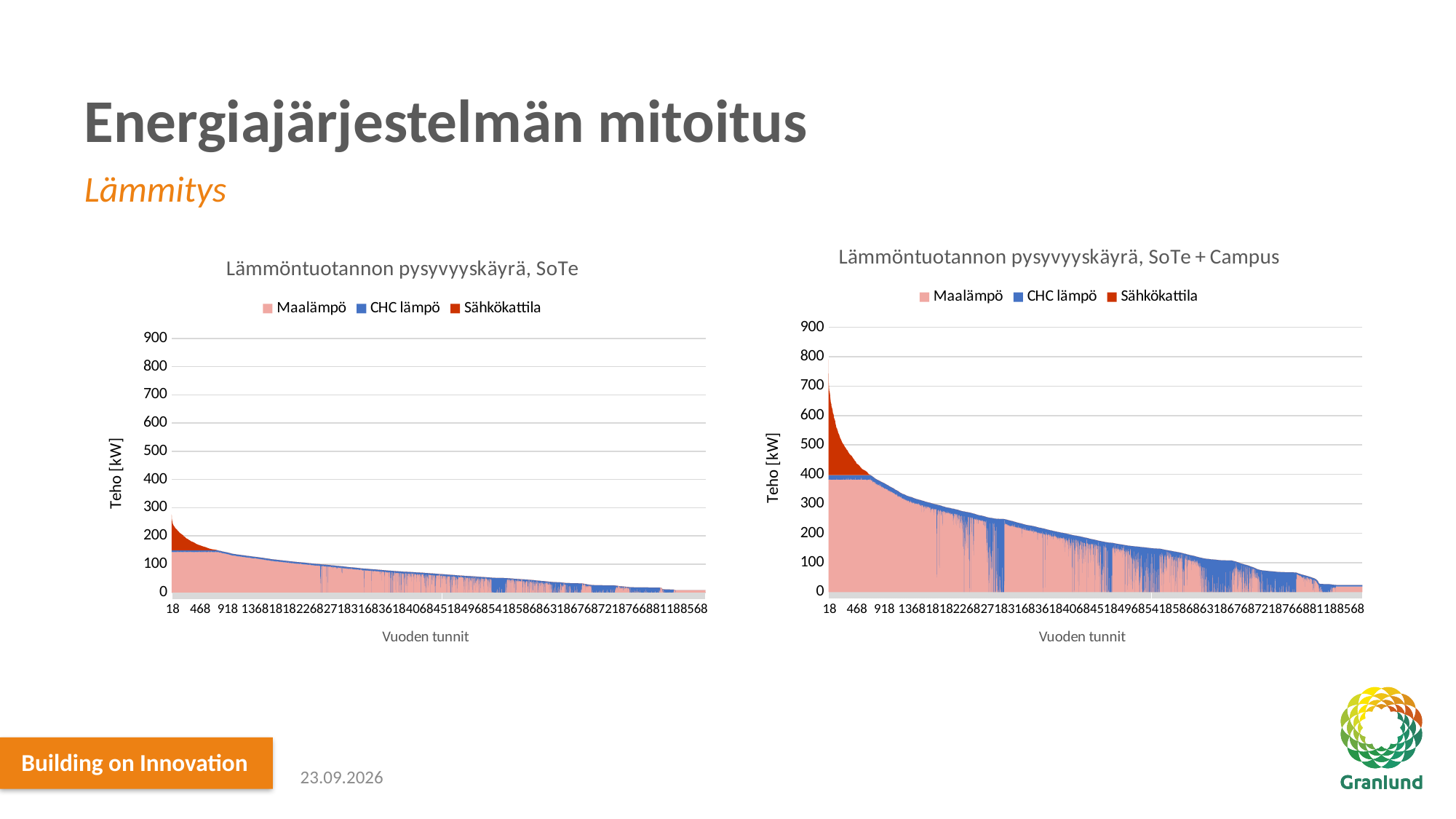
What is the y-axis label of the right chart, 'Lämmöntuotannon pysyvyyskäyrä, SoTe + Campus'? Teho [kW] In the left chart, 'Lämmöntuotannon pysyvyyskäyrä, SoTe', do the values rise or fall along the x axis? Fall In the right chart, 'Lämmöntuotannon pysyvyyskäyrä, SoTe + Campus', is the highest total value (at the left edge) greater or less than 700? greater Which chart reaches a higher peak total value: 'Lämmöntuotannon pysyvyyskäyrä, SoTe' or 'Lämmöntuotannon pysyvyyskäyrä, SoTe + Campus'? Lämmöntuotannon pysyvyyskäyrä, SoTe + Campus In the left chart, 'Lämmöntuotannon pysyvyyskäyrä, SoTe', is the flat top of the Maalämpö area at the left greater or less than 100? greater In the left chart, 'Lämmöntuotannon pysyvyyskäyrä, SoTe', which series are listed in the legend? Maalämpö, CHC lämpö, Sähkökattila In the right chart, 'Lämmöntuotannon pysyvyyskäyrä, SoTe + Campus', do the values rise or fall along the x axis? Fall How many series does the legend of the right chart, 'Lämmöntuotannon pysyvyyskäyrä, SoTe + Campus', list? 3 In the left chart, 'Lämmöntuotannon pysyvyyskäyrä, SoTe', is the highest total value (at the left edge) greater or less than 300? less What kind of chart is the left chart, 'Lämmöntuotannon pysyvyyskäyrä, SoTe'? Stacked area chart